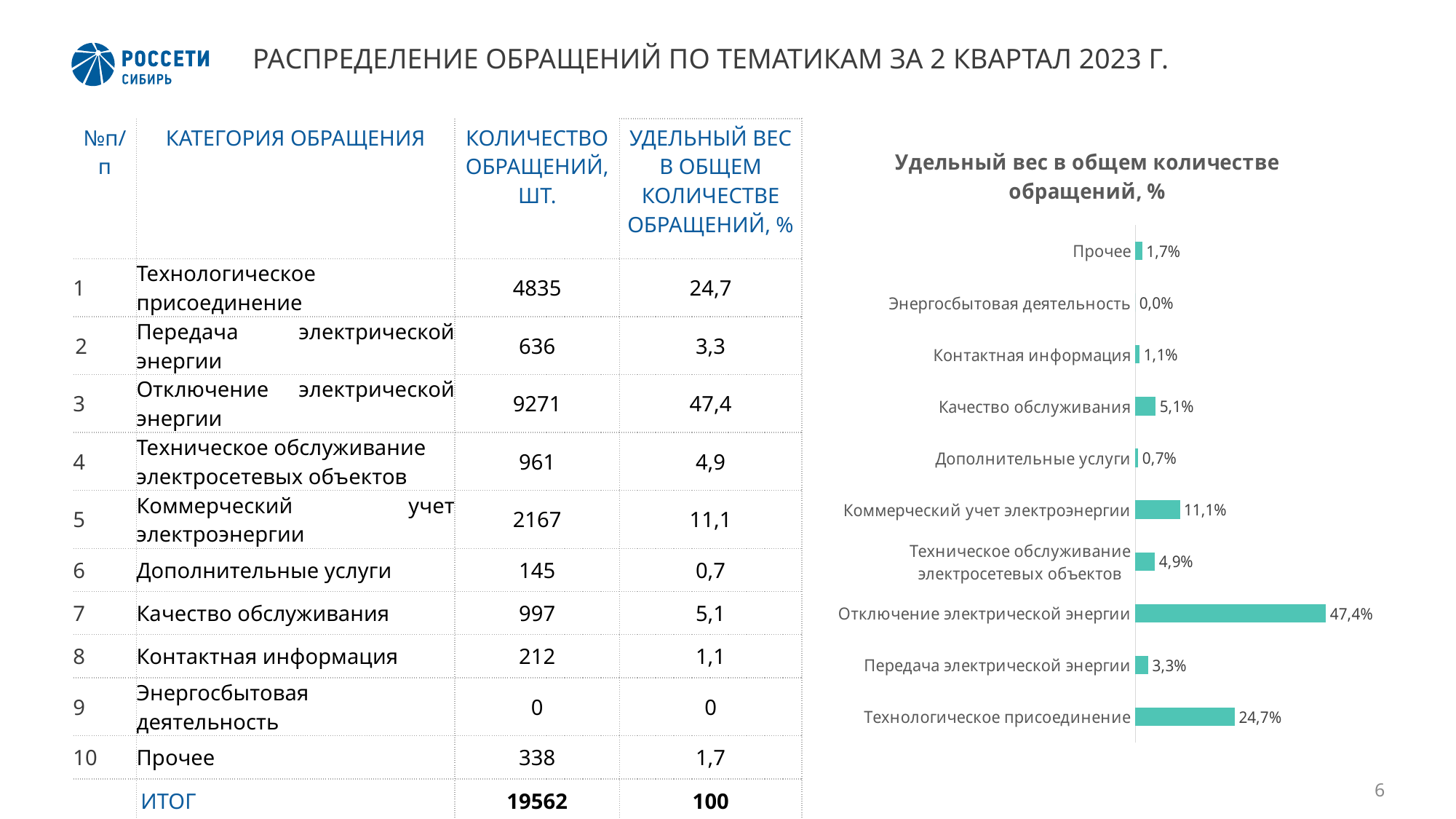
What is the difference between the values for Коммерческий учет электроэнергии and Передача электрической энергии? 7,8% What is the value for Коммерческий учет электроэнергии in the chart? 11,1% Which category has the highest value in the chart? Отключение электрической энергии What kind of chart is shown on the slide? Bar chart What is the value for Качество обслуживания in the chart? 5,1% How many categories are shown in the chart? 10 Which is larger: the value for Качество обслуживания or the value for Техническое обслуживание электросетевых объектов? Качество обслуживания What is the difference between the values for Отключение электрической энергии and Технологическое присоединение? 22,7% Which category has the lowest value in the chart? Энергосбытовая деятельность Which is larger: the value for Прочее or the value for Контактная информация? Прочее What is the title of the chart? Удельный вес в общем количестве обращений, % What is the value for Отключение электрической энергии in the chart? 47,4%